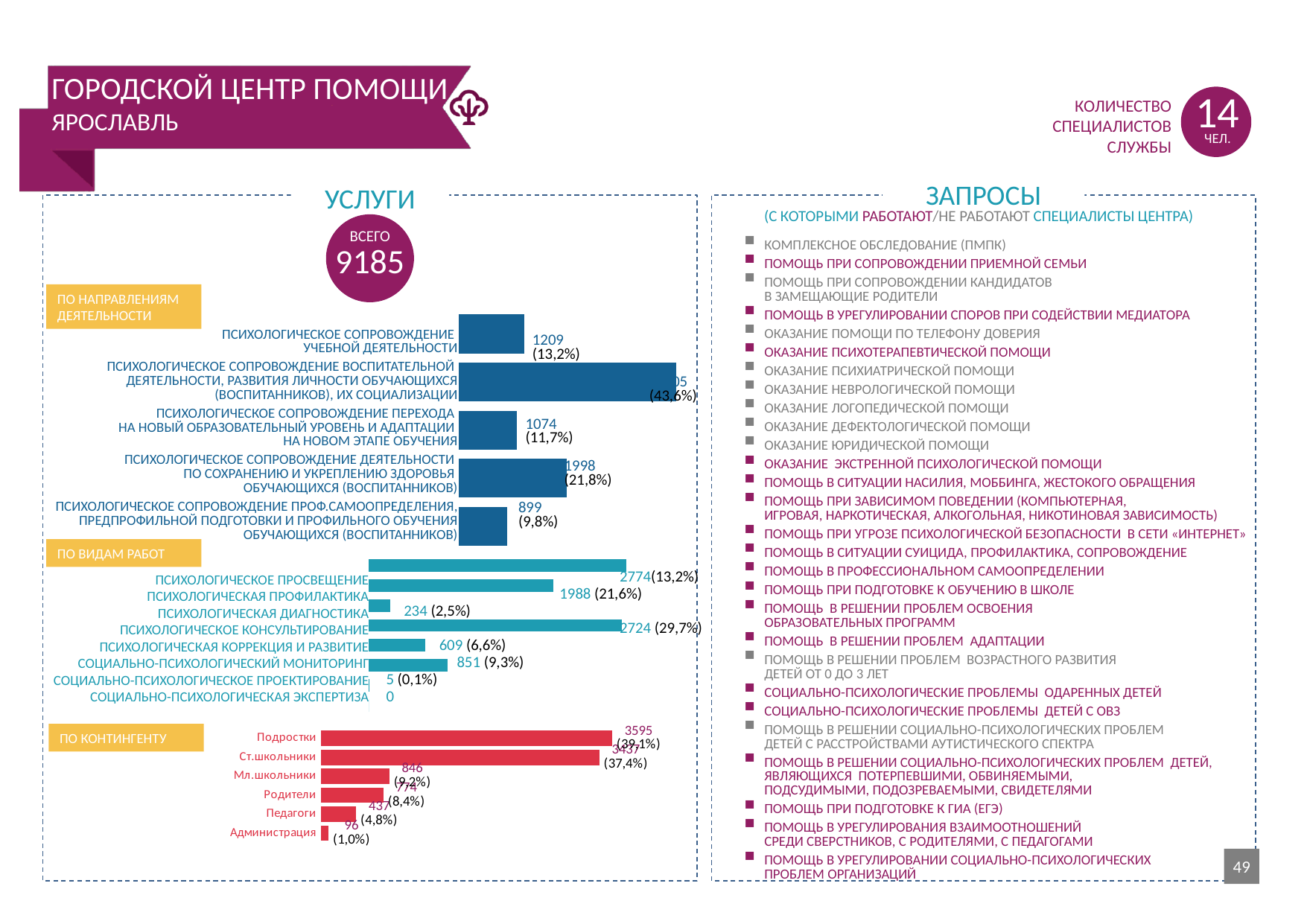
What type of chart is the 'ПО КОНТИНГЕНТУ' chart? Bar chart In the 'ПО ВИДАМ РАБОТ' chart, what is the difference between 'Социально-психологический мониторинг' and 'Психологическая коррекция и развитие'? 242 In the 'ПО НАПРАВЛЕНИЯМ ДЕЯТЕЛЬНОСТИ' chart, what is the value for 'Психологическое сопровождение проф.самоопределения, предпрофильной подготовки и профильного обучения обучающихся (воспитанников)'? 899 (9,8%) In the 'ПО ВИДАМ РАБОТ' chart, how many categories are listed? 8 In the 'ПО ВИДАМ РАБОТ' chart, which is larger: 'Психологическая профилактика' or 'Социально-психологический мониторинг'? Психологическая профилактика In the 'ПО НАПРАВЛЕНИЯМ ДЕЯТЕЛЬНОСТИ' chart, which category has the lowest value? Психологическое сопровождение проф.самоопределения, предпрофильной подготовки и профильного обучения обучающихся (воспитанников) In the 'ПО НАПРАВЛЕНИЯМ ДЕЯТЕЛЬНОСТИ' chart, what is the value for 'Психологическое сопровождение учебной деятельности'? 1209 (13,2%) In the 'ПО КОНТИНГЕНТУ' chart, what is the value for 'Подростки'? 3595 (39,1%) In the 'ПО НАПРАВЛЕНИЯМ ДЕЯТЕЛЬНОСТИ' chart, how many categories are shown? 5 In the 'ПО ВИДАМ РАБОТ' chart, which category has the highest value? Психологическое просвещение In the 'ПО ВИДАМ РАБОТ' chart, what is the value for 'Психологическая диагностика'? 234 (2,5%) In the 'ПО КОНТИНГЕНТУ' chart, which category has the lowest value? Администрация